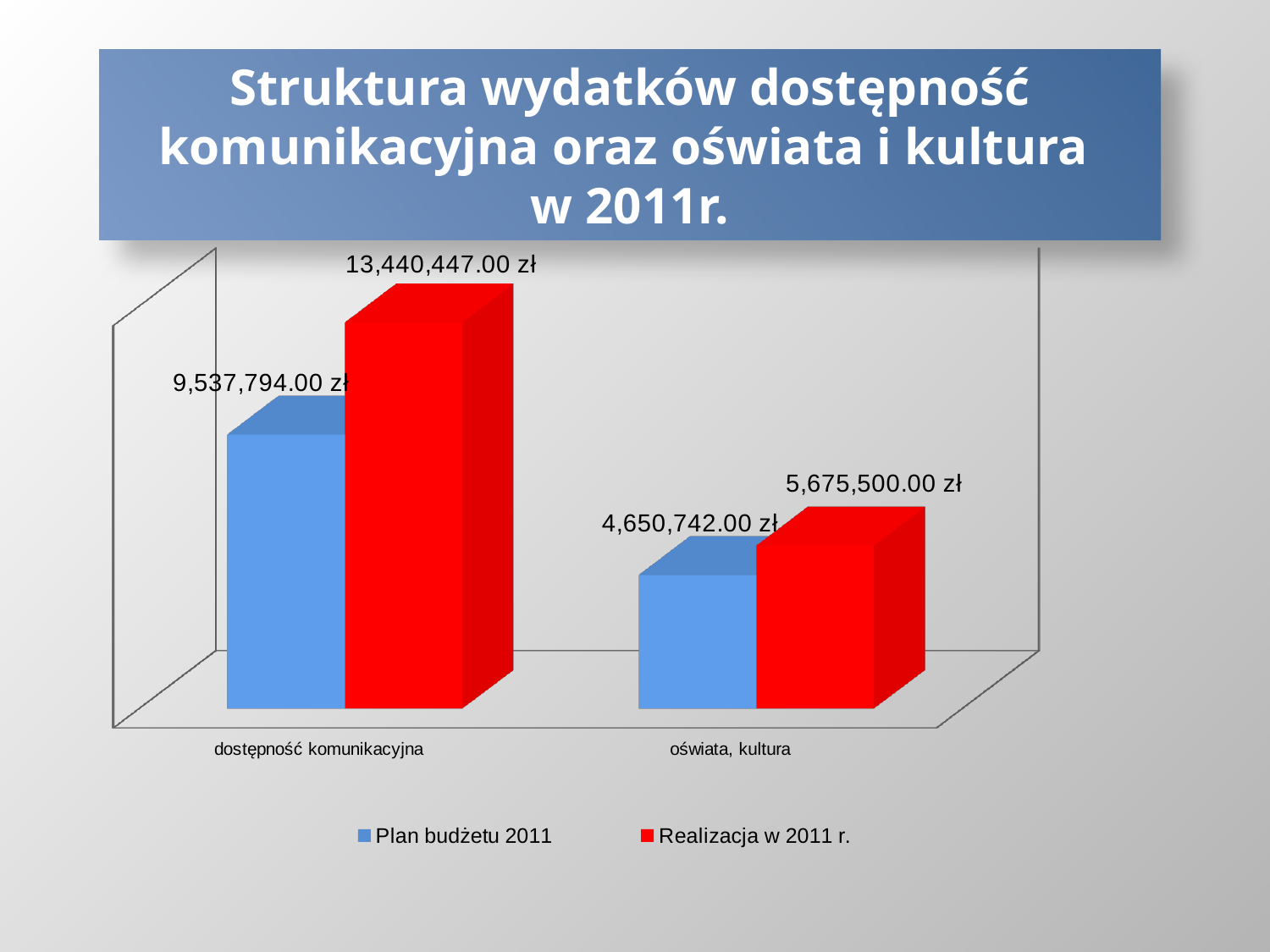
What is the value of Realizacja w 2011 r. for dostępność komunikacyjna? 13,440,447.00 zł What is the difference between Realizacja w 2011 r. and Plan budżetu 2011 for dostępność komunikacyjna? 3,902,653.00 zł Which category has the highest Realizacja w 2011 r. value? dostępność komunikacyjna What is the value of Plan budżetu 2011 for oświata, kultura? 4,650,742.00 zł What is the difference between Realizacja w 2011 r. and Plan budżetu 2011 for oświata, kultura? 1,024,758.00 zł How many series does the legend list? 2 How many categories are shown on the x axis? 2 What is the value of Realizacja w 2011 r. for oświata, kultura? 5,675,500.00 zł Which category has the lowest Plan budżetu 2011 value? oświata, kultura What kind of chart is shown on the slide? bar chart For oświata, kultura, which is larger: Plan budżetu 2011 or Realizacja w 2011 r.? Realizacja w 2011 r. What is the value of Plan budżetu 2011 for dostępność komunikacyjna? 9,537,794.00 zł